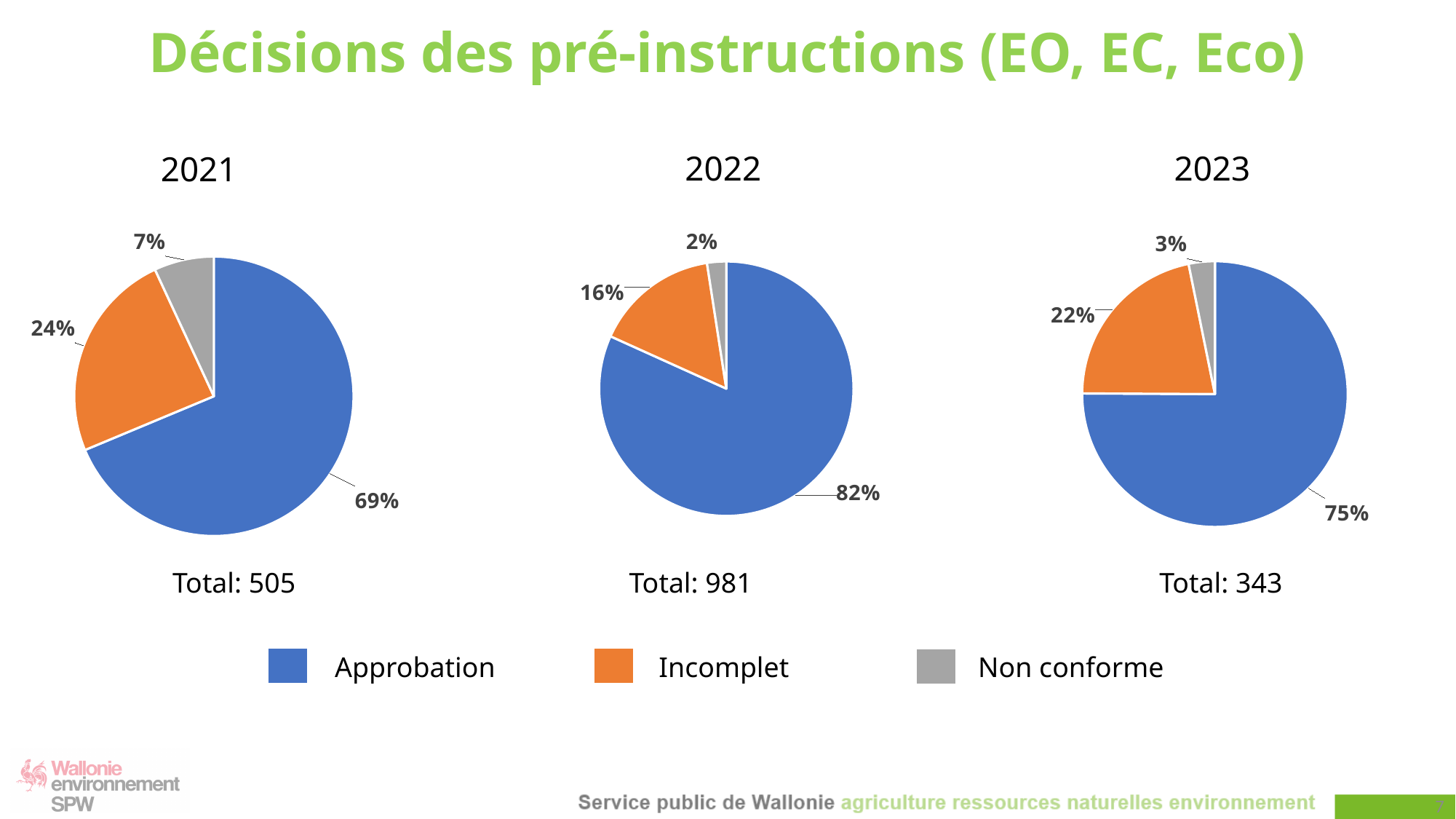
In the 2022 pie chart, what share is Incomplet? 16% What kind of chart is used for each year on this slide? Pie chart What is the total shown under the 2022 pie chart? 981 In the 2021 pie chart, which category has the smallest slice? Non conforme Which colour represents Non conforme in the legend? Grey How many categories does the legend list? 3 In the 2021 pie chart, what share is Approbation? 69% Is the Incomplet share larger in the 2021 pie chart or in the 2023 pie chart? 2021 In the 2022 pie chart, which category has the largest slice? Approbation How many pie charts are on the slide? 3 In the 2023 pie chart, what is the difference between the Approbation share and the Incomplet share? 53% In the 2023 pie chart, what share is Non conforme? 3%